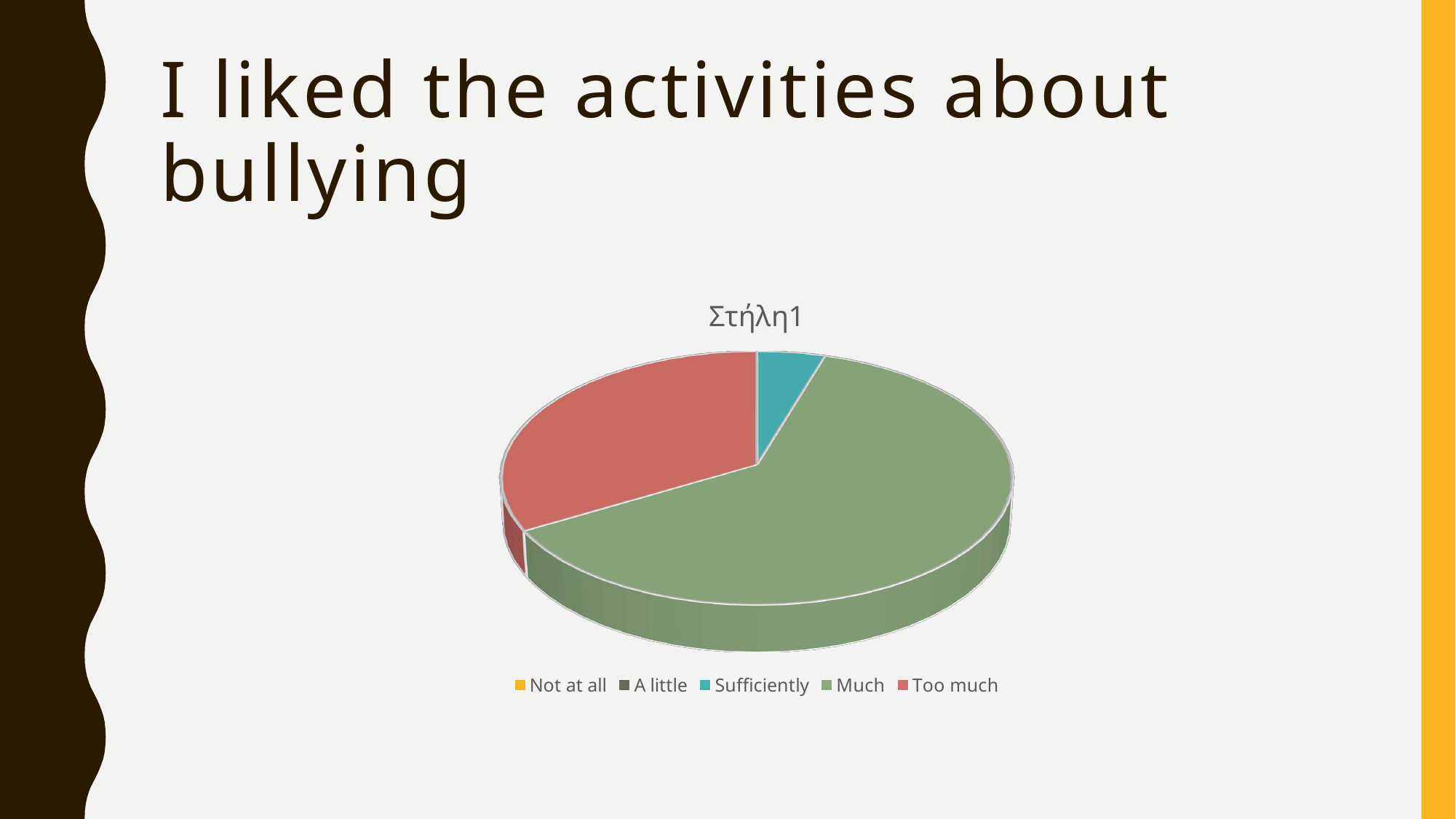
Which category has the largest slice of the pie? Much What colour is the slice for Too much? red What kind of chart is shown on the slide? pie chart Which slice is larger, Much or Too much? Much Which slice is larger, Too much or Sufficiently? Too much Does the Much slice take up more or less than half of the pie? more How many categories does the legend list? 5 What is the title shown above the pie chart? Στήλη1 Which of the visible slices is the smallest? Sufficiently How many slices are visible in the pie? 3